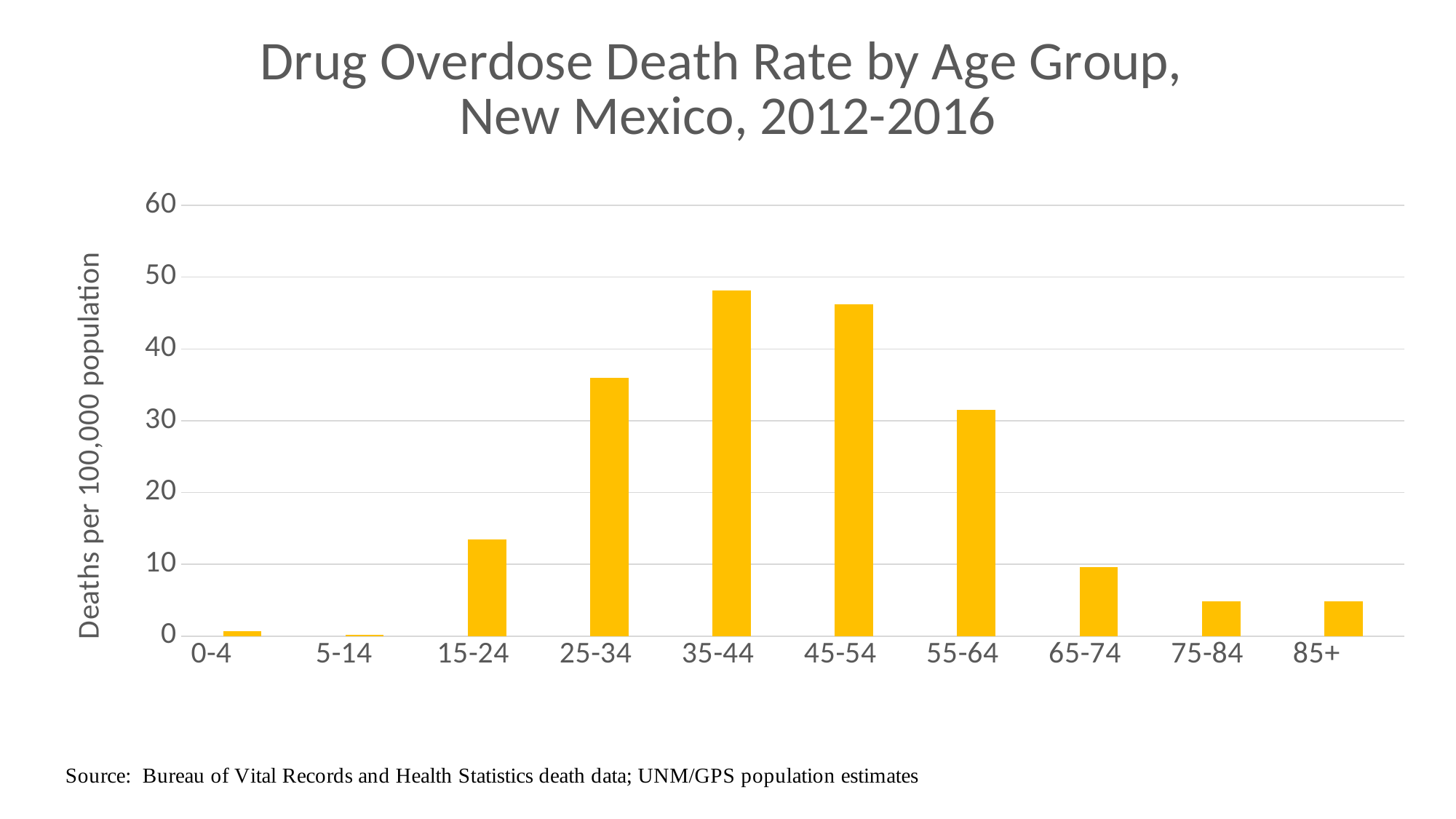
Is the value for the 35-44 age group greater or less than 40? greater Which age group has the lowest drug overdose death rate? 5-14 Is the value for the 25-34 age group greater or less than 40? less How many age groups are shown on the x axis? 10 Do the values rise or fall from the 35-44 age group to the 85+ age group? fall Which has the higher death rate, the 25-34 age group or the 55-64 age group? 25-34 What kind of chart is shown on the slide? bar chart What is the label on the y axis? Deaths per 100,000 population Is the value for the 55-64 age group greater or less than 30? greater Which age group has the highest drug overdose death rate? 35-44